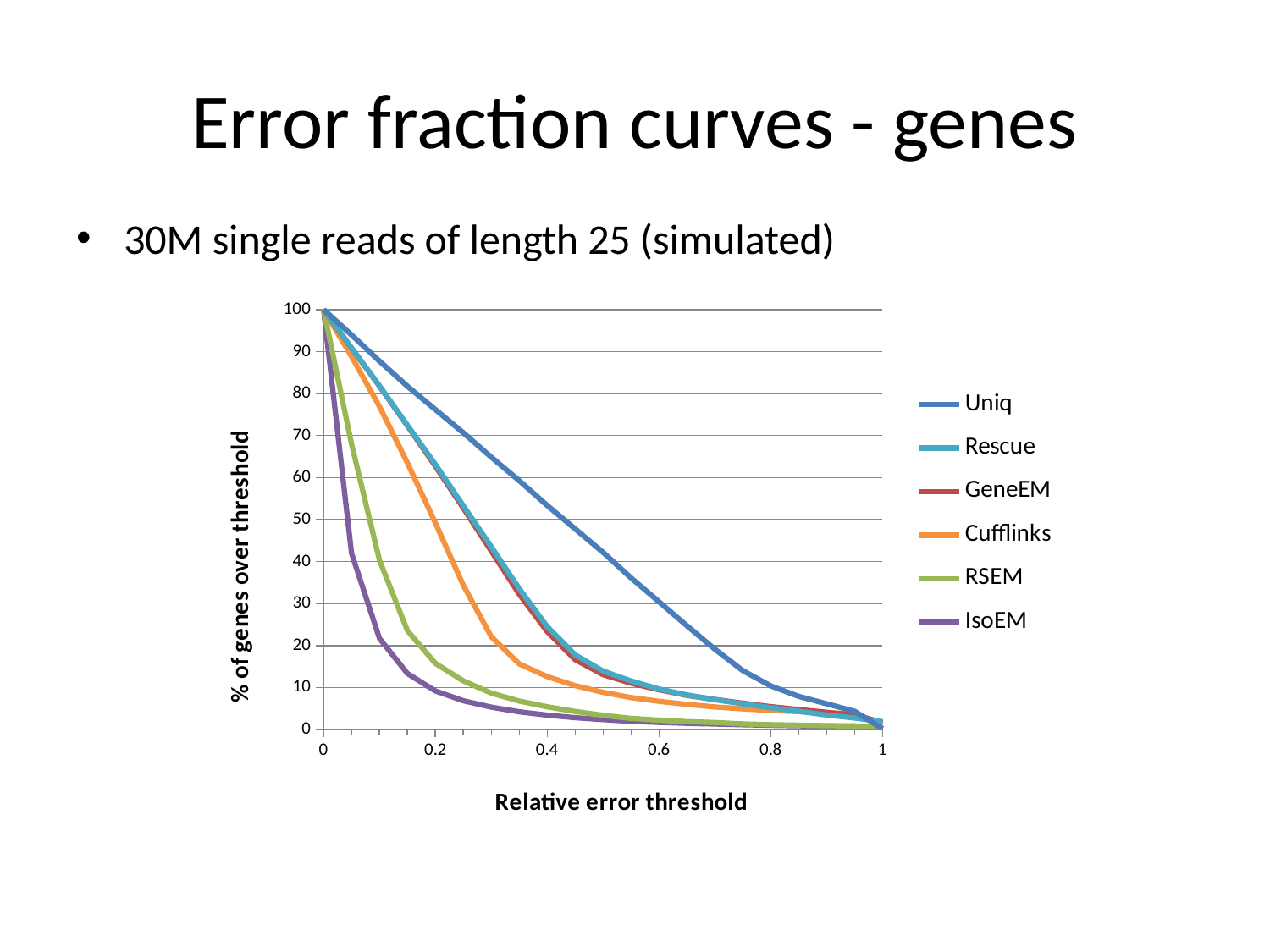
Do the curves rise or fall as the relative error threshold increases? fall What kind of chart is shown on the slide? line chart Which series has the highest value at a relative error threshold of 0.4? Uniq What is the title of the x axis? Relative error threshold Is the value for Uniq at a relative error threshold of 0.5 greater or less than 30? greater What is the title of the y axis? % of genes over threshold How many series does the legend list? 6 What is the value of the Uniq series at a relative error threshold of 0? 100 Which series has the lowest value at a relative error threshold of 0.2? IsoEM At a relative error threshold of 0.4, which is larger, Uniq or IsoEM? Uniq Is the value for Cufflinks at a relative error threshold of 0.4 greater or less than 20? less Is the value for Uniq at a relative error threshold of 0.8 greater or less than 20? less